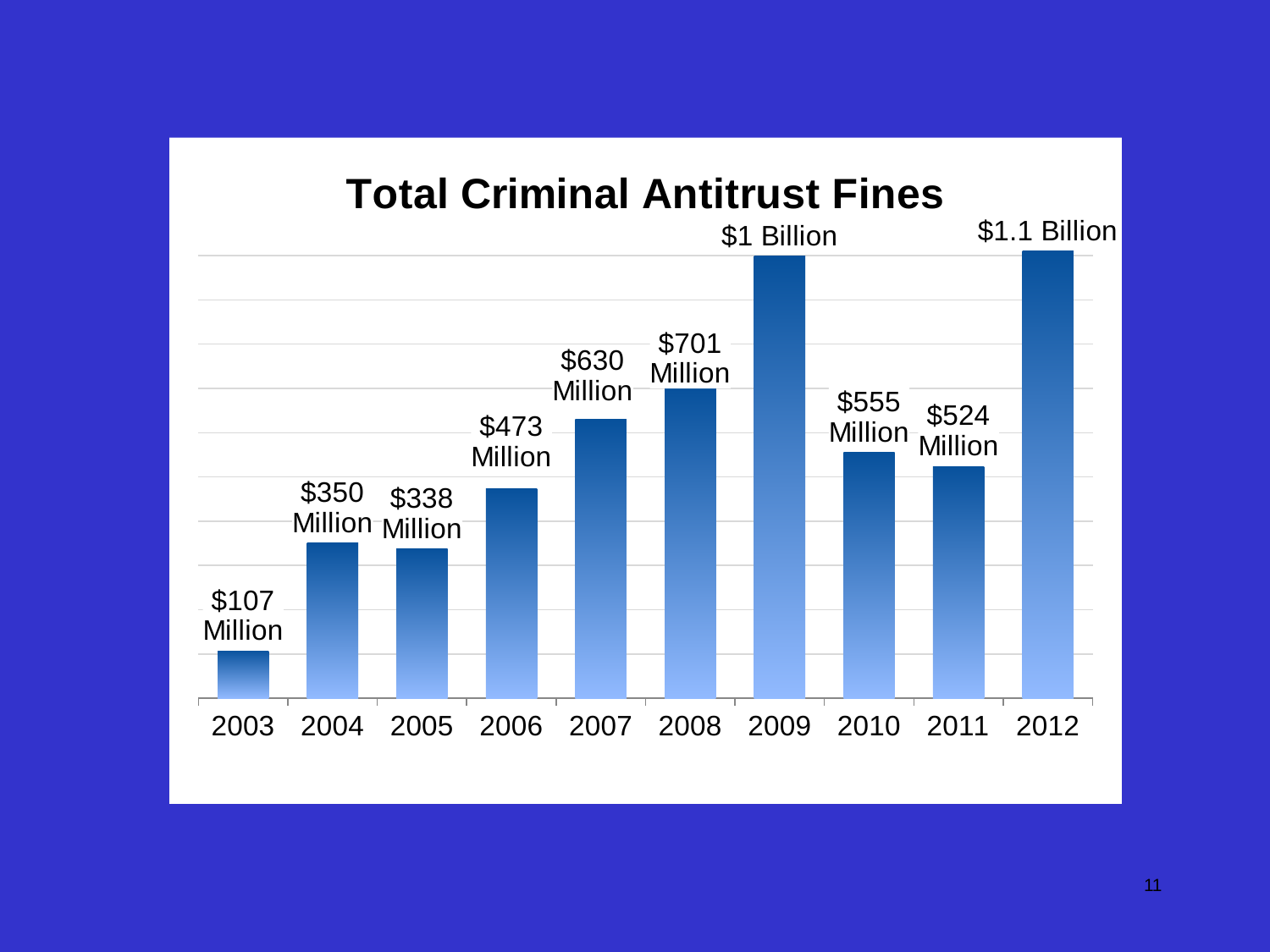
What is the title of the chart? Total Criminal Antitrust Fines How many years are shown on the x axis? 10 What is the value shown for 2003? $107 Million What is the value shown for 2010? $555 Million What is the difference between the fines in 2008 and 2007? $71 Million Which year has the lowest total criminal antitrust fines? 2003 What is the difference between the fines in 2010 and 2011? $31 Million What kind of chart is shown on the slide? Bar chart Which year had higher fines, 2004 or 2005? 2004 Which year had higher fines, 2009 or 2012? 2012 Which year has the highest total criminal antitrust fines? 2012 What is the total criminal antitrust fine shown for 2007? $630 Million